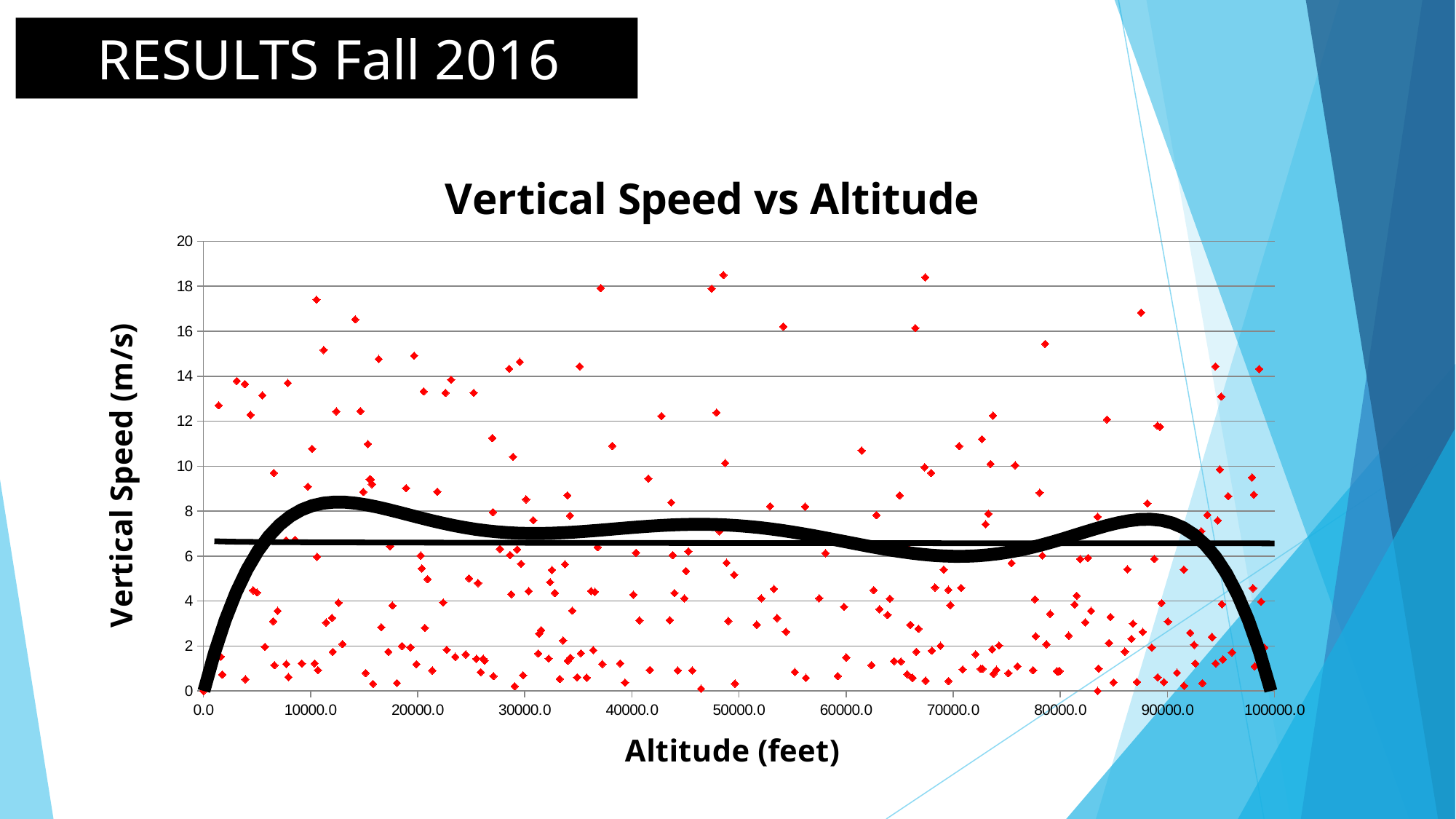
What is the title of the chart? Vertical Speed vs Altitude Is the straight horizontal trend line greater or less than 6 m/s? greater Is the curved trend line at 70000.0 feet greater or less than 8 m/s? less What is the highest value shown on the horizontal axis? 100000.0 What is the highest value shown on the vertical axis? 20 Does the curved trend line rise or fall between 0.0 and 10000.0 feet? rise What is the label of the vertical axis? Vertical Speed (m/s) How many tick labels are shown on the horizontal axis? 11 Is the straight horizontal trend line greater or less than 8 m/s? less Does the curved trend line rise or fall between 90000.0 and 100000.0 feet? fall What kind of chart is shown on the slide? Scatter chart